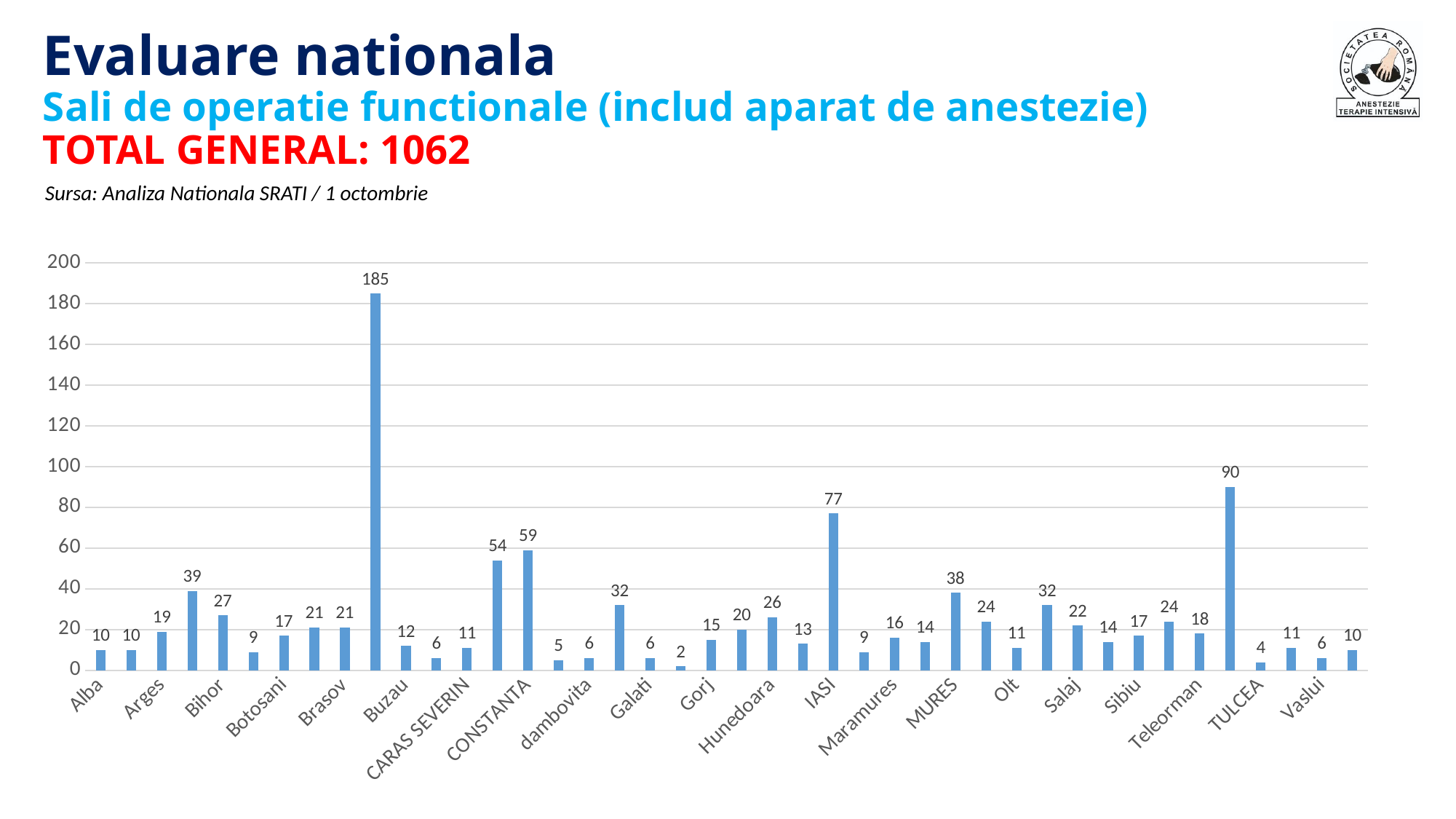
What is the value for Hunedoara? 26 What is the value for IASI? 77 What is the difference between the values for IASI and CONSTANTA? 18 Is the value for IASI greater or less than 60? greater What type of chart is shown on the slide? bar chart Which has a larger value, MURES or Bihor? MURES What is the value for CONSTANTA? 59 What is the value for MURES? 38 What is the highest value shown on the chart? 185 What is the lowest value shown on the chart? 2 What is the value for TULCEA? 4 What is the TOTAL GENERAL stated on the slide? 1062